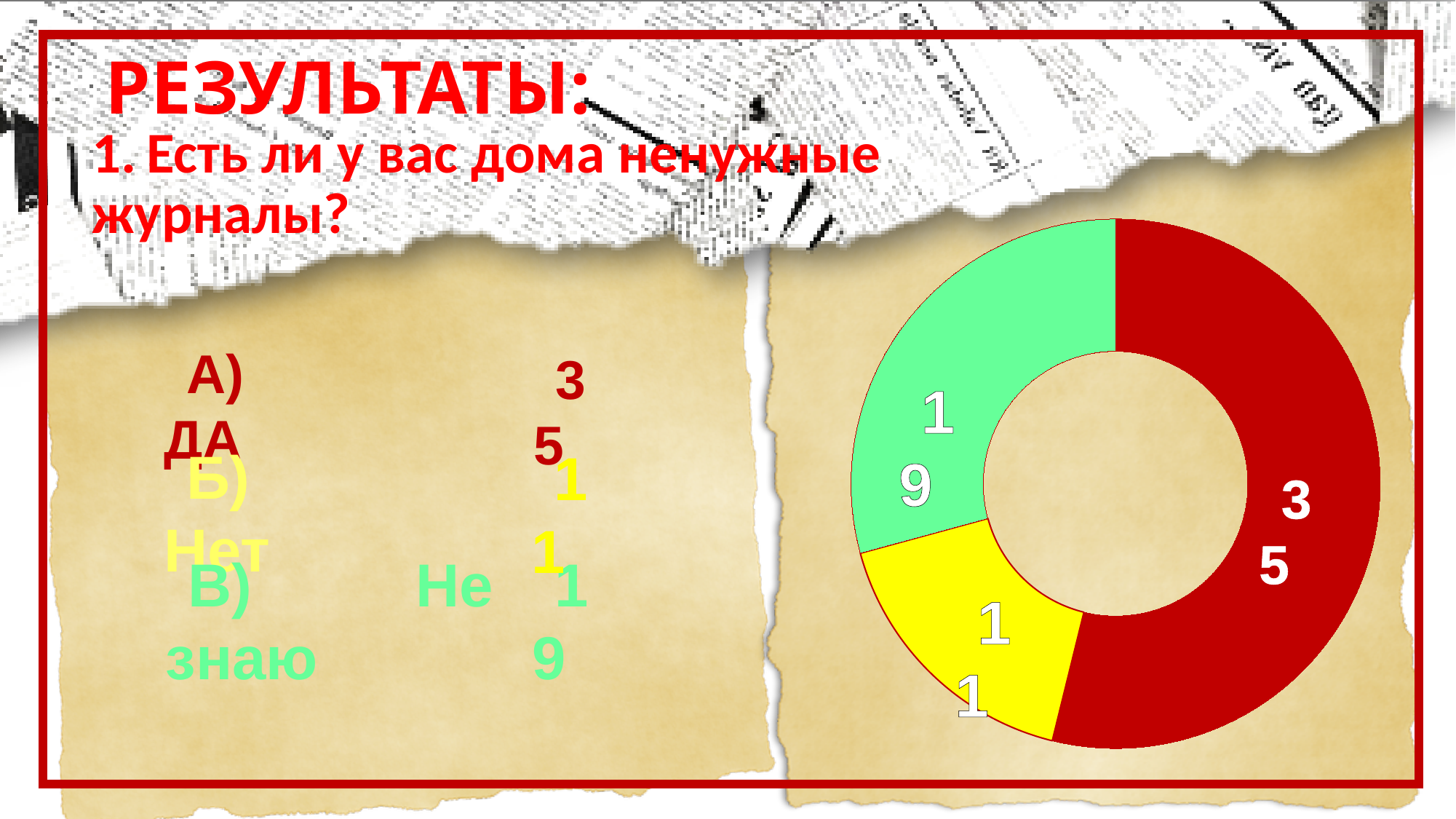
What kind of chart is shown on the slide? doughnut (pie) chart What is the difference between the values for Не знаю and Нет? 8 What is the total of all three slices in the chart? 65 Which answer option has the largest slice in the chart? ДА What is the difference between the values for ДА and Не знаю? 16 What is the value of the yellow slice (Нет)? 11 How many slices does the doughnut chart have? 3 What is the value of the red slice (ДА)? 35 What colour is the slice for ДА? red Which is larger, the value for Нет or the value for Не знаю? Не знаю Which answer option has the smallest slice in the chart? Нет What is the value of the green slice (Не знаю)? 19